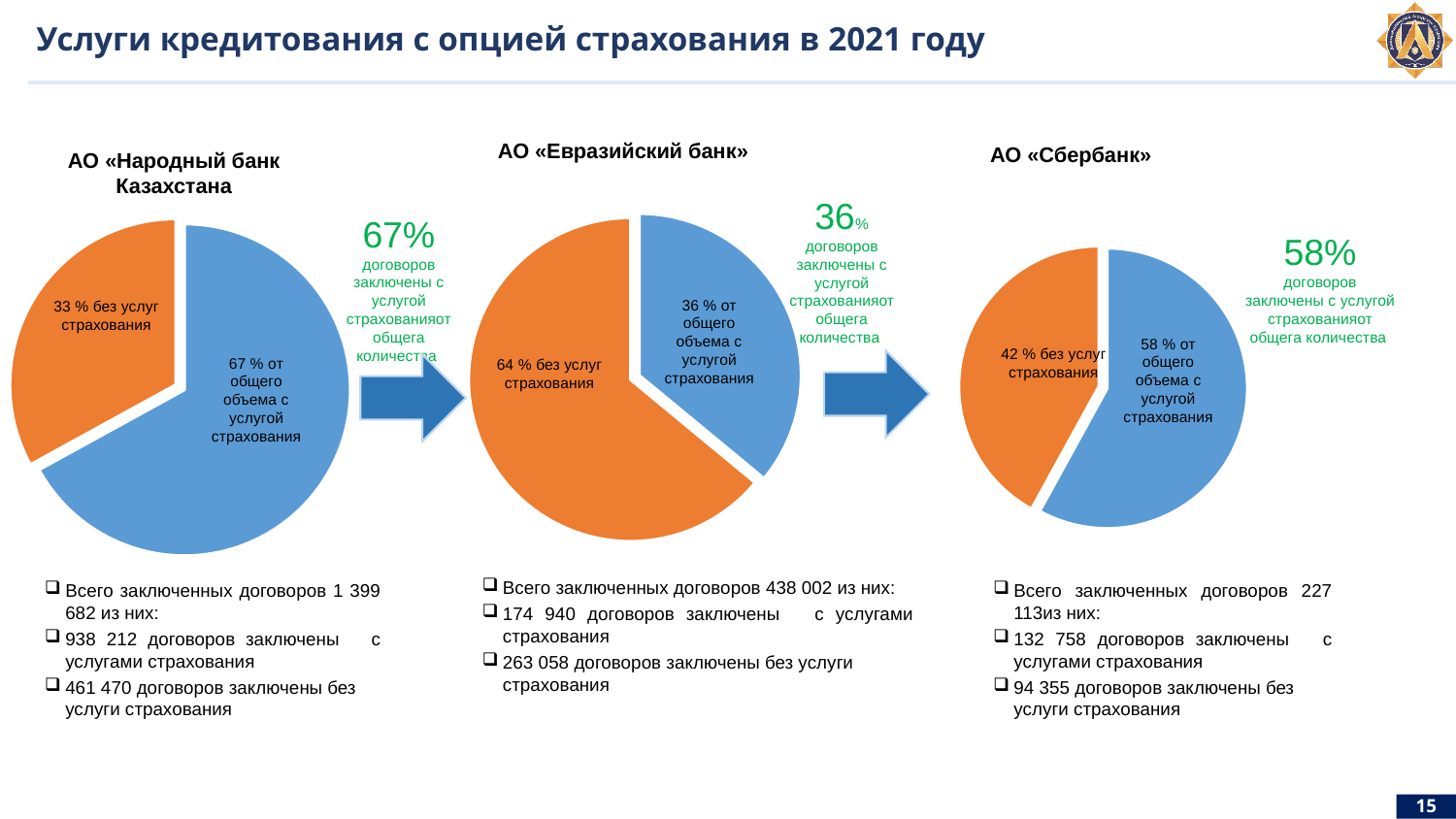
In the АО «Народный банк Казахстана» pie chart, what share of contracts were concluded without the insurance service? 33 % In the АО «Народный банк Казахстана» pie chart, what share of contracts were concluded with the insurance service? 67 % In the АО «Народный банк Казахстана» pie chart, by how many percentage points does the share with insurance exceed the share without insurance? 34 percentage points Across the three pie charts, which bank has the highest share of contracts concluded with the insurance service? АО «Народный банк Казахстана» In the АО «Евразийский банк» pie chart, what share of contracts were concluded without the insurance service? 64 % What kind of chart is used for АО «Народный банк Казахстана»? pie chart In the АО «Сбербанк» pie chart, what share of contracts were concluded with the insurance service? 58 % How many slices does the АО «Сбербанк» pie chart have? 2 In the pie charts, what colour is the slice for contracts without the insurance service? orange In the АО «Евразийский банк» pie chart, what share of contracts were concluded with the insurance service? 36 % In the АО «Сбербанк» pie chart, what share of contracts were concluded without the insurance service? 42 % In the АО «Евразийский банк» pie chart, which slice is larger: with the insurance service or without the insurance service? без услуг страхования